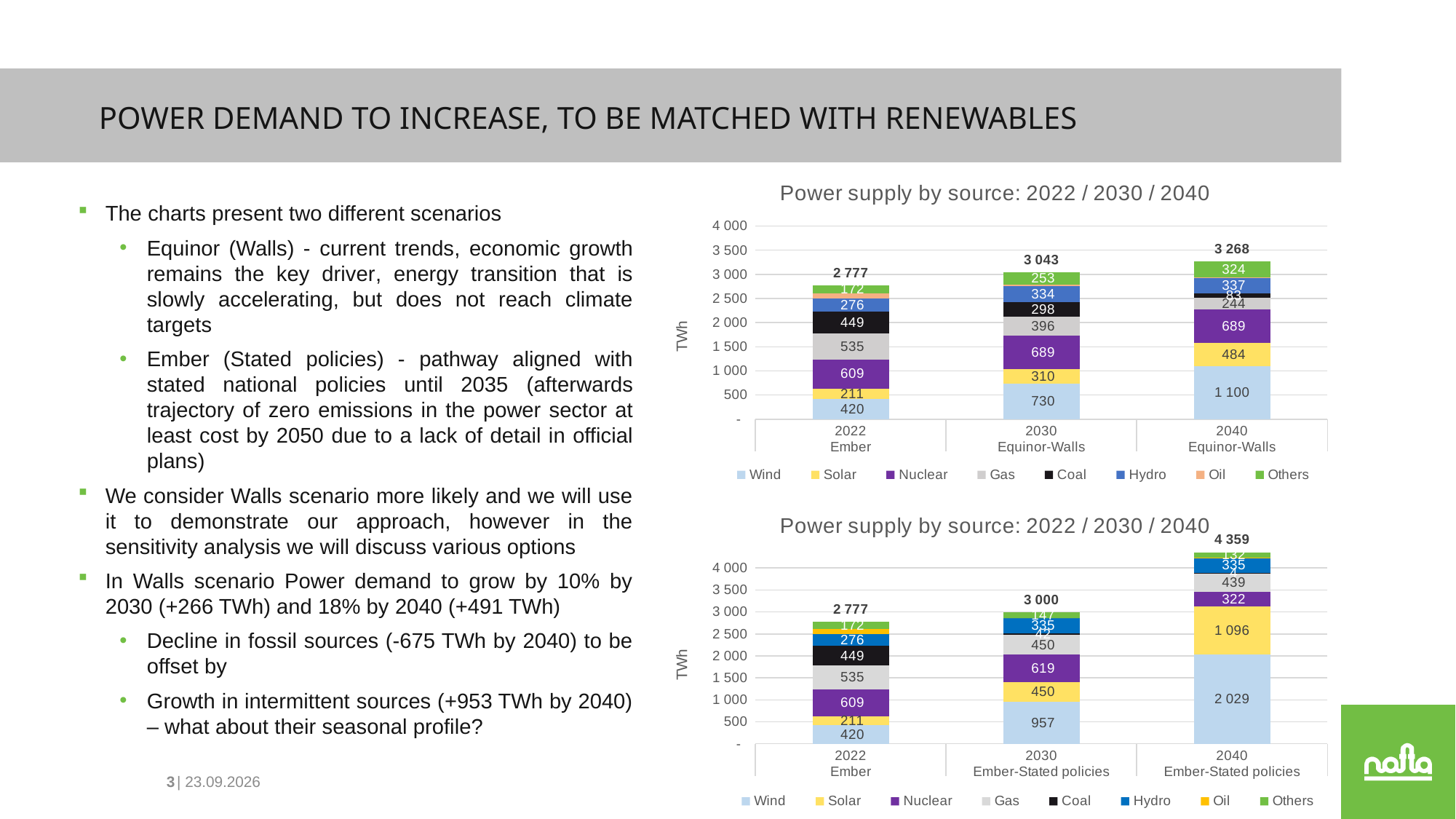
In the top chart (Equinor-Walls scenario), which year has the highest total power supply? 2040 How many series does the legend of the top chart list? 8 In the top chart (Equinor-Walls scenario), what is the difference between the Wind values for 2040 and 2022? 680 In the bottom chart (Ember-Stated policies scenario), what is the Solar value for 2040? 1 096 In the bottom chart (Ember-Stated policies scenario), what is the total power supply shown for 2040? 4 359 In the bottom chart (Ember-Stated policies scenario), what is the Wind value for 2040? 2 029 In the top chart (Equinor-Walls scenario), what is the Wind value for 2030? 730 In the bottom chart (Ember-Stated policies scenario), do the total values rise or fall from 2022 to 2040? Rise In the top chart (Equinor-Walls scenario), what is the total power supply shown for 2040? 3 268 What kind of chart is the bottom chart? Stacked bar chart In the bottom chart (Ember-Stated policies scenario), is the Wind value for 2030 larger than the Nuclear value for 2030? Yes In the top chart (Equinor-Walls scenario), what is the Nuclear value for 2022 Ember? 609